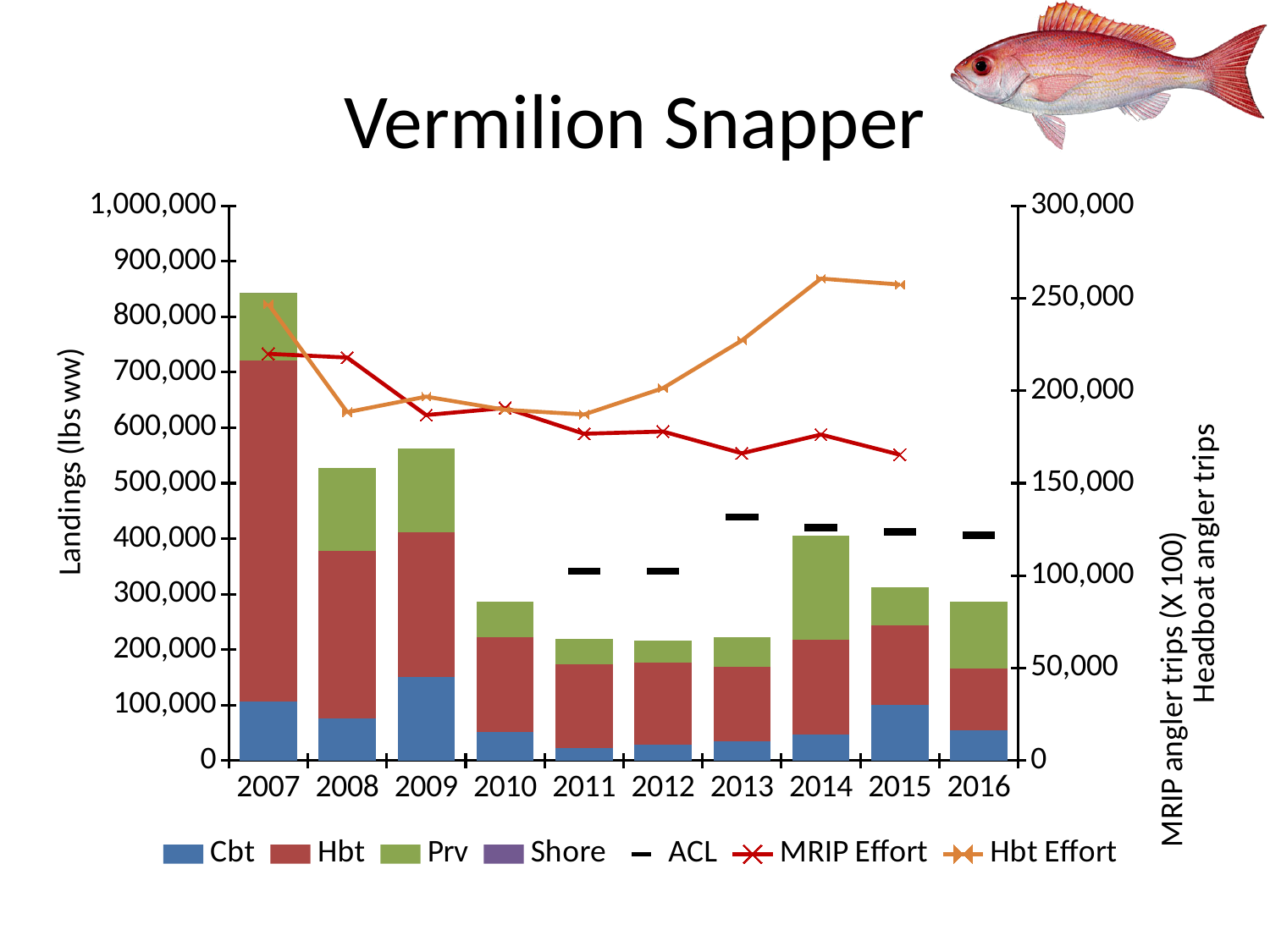
Is the Hbt Effort value for 2014 greater or less than 250,000? greater Is the total landings value for 2007 greater or less than 800,000? greater Which year has the highest total landings? 2007 What is the title of the left vertical axis? Landings (lbs ww) Is the total landings value for 2011 greater or less than 300,000? less How many years are shown on the x axis of the chart? 10 Does the Hbt Effort line rise or fall from 2012 to 2015? rises Which is higher in 2015, the Hbt Effort line or the MRIP Effort line? Hbt Effort Which year has larger total landings, 2014 or 2015? 2014 What kind of chart is shown on the slide? A combined bar and line chart (stacked bars with lines) How many series does the chart legend list? 7